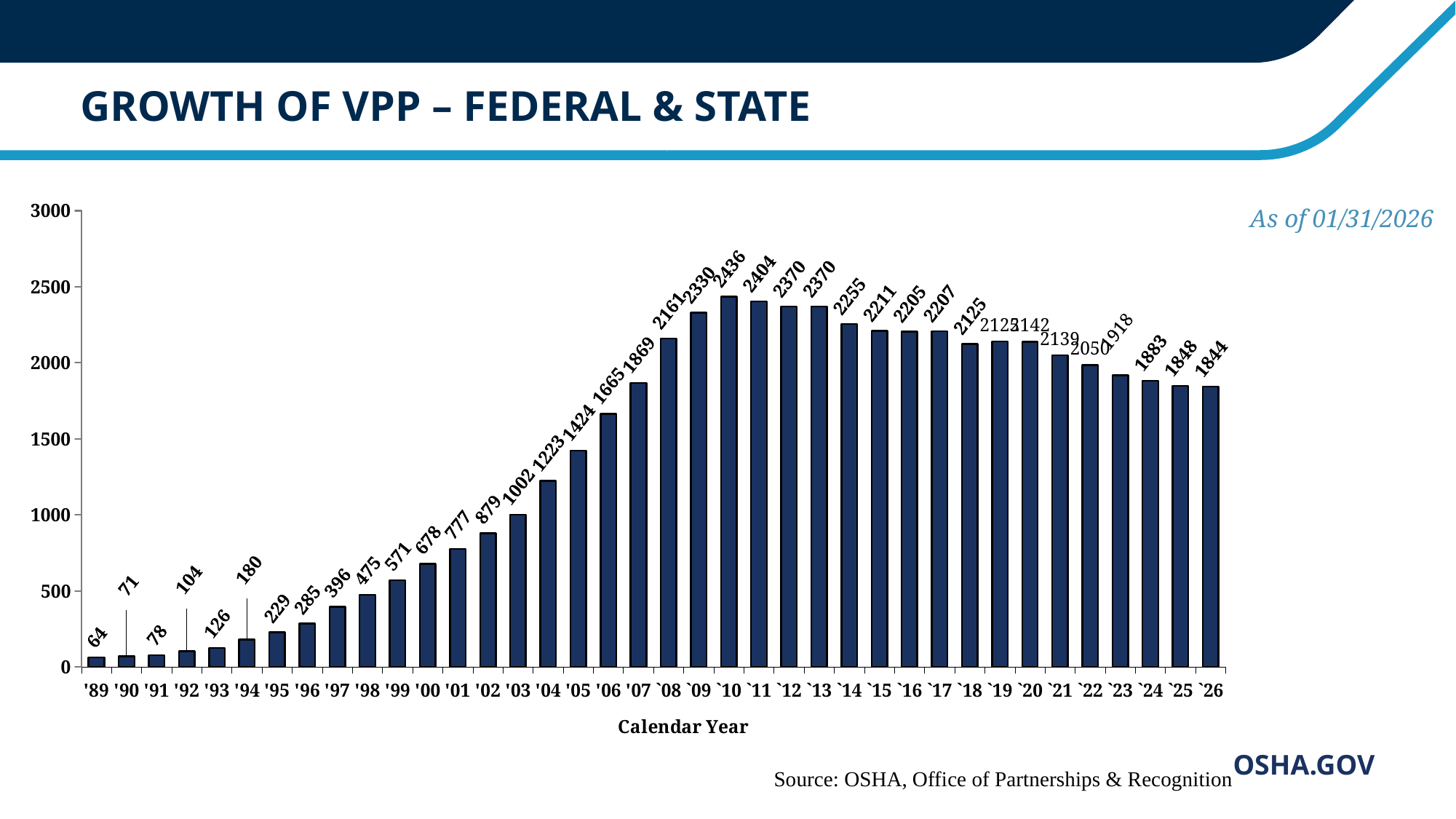
What is the title of the x axis? Calendar Year Which calendar year has the lowest value in the chart? '89 Which calendar year has the highest value in the chart? '10 What kind of chart is shown on the slide? bar chart What is the value for '94? 180 Which is larger, the value for '08 or the value for '09? '09 What is the value for '00? 678 Do the values rise or fall from '89 to '10? rise What is the value for '10? 2436 What is the difference between the values for '10 and '26? 592 How many calendar years (bars) are plotted in the chart? 38 What is the value for '26? 1844